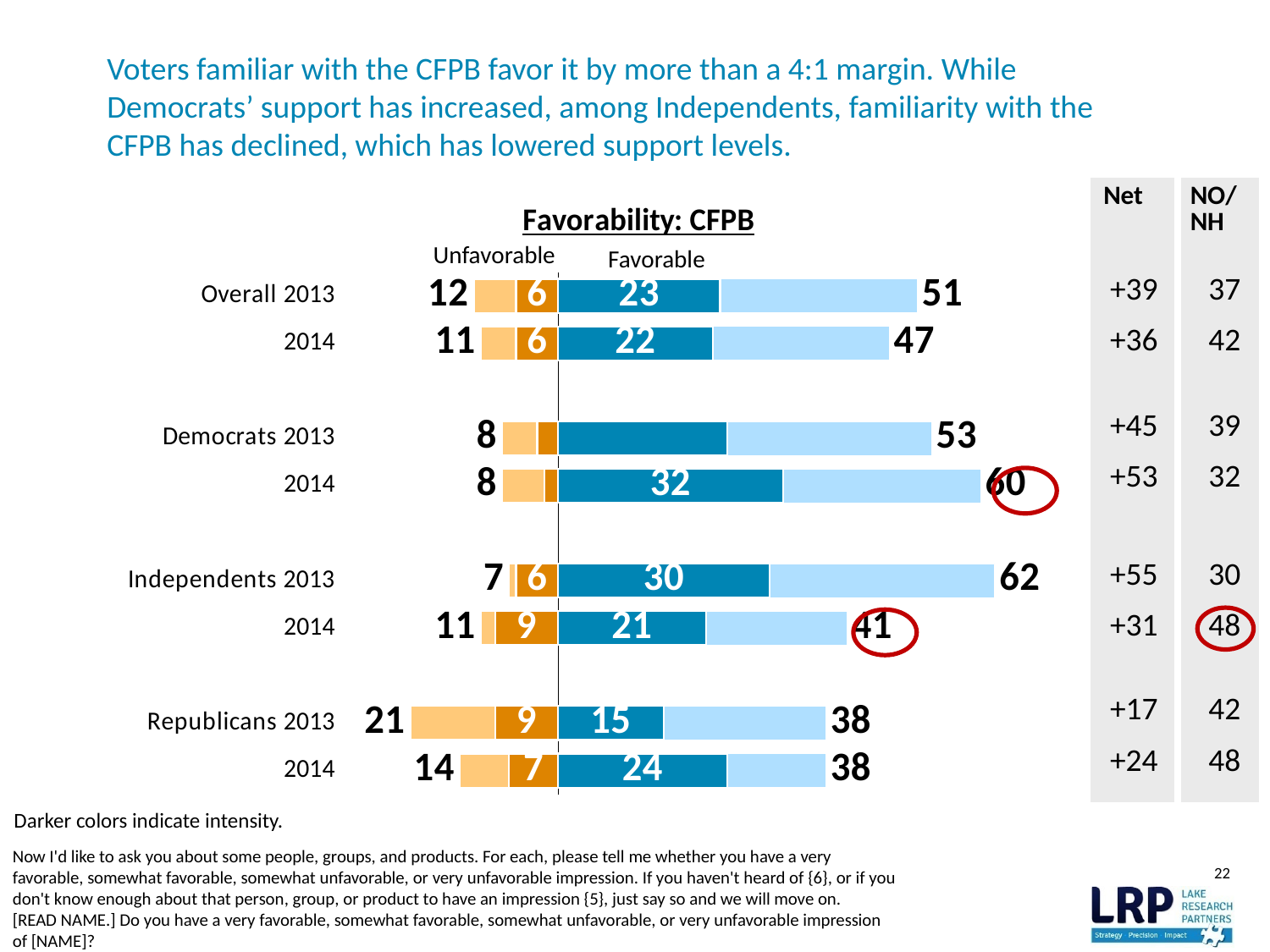
What is the Net value shown for Democrats 2014? +53 What is the total unfavorable value for Republicans 2013? 21 What is the difference between the total favorable values for Independents 2013 and Independents 2014? 21 Which is larger, the total favorable value for Democrats 2014 or for Overall 2014? Democrats 2014 Which group and year has the highest total favorable value? Independents 2013 How many bars (group-year rows) are plotted in the chart? 8 Which group and year has the highest total unfavorable value? Republicans 2013 What type of chart is shown on the slide? Stacked bar chart What is the very favorable (dark blue) value for Democrats 2014? 32 What is the NO/NH value shown for Independents 2014? 48 What is the very unfavorable (dark orange) value for Independents 2014? 9 What is the total favorable value for Overall 2013? 51